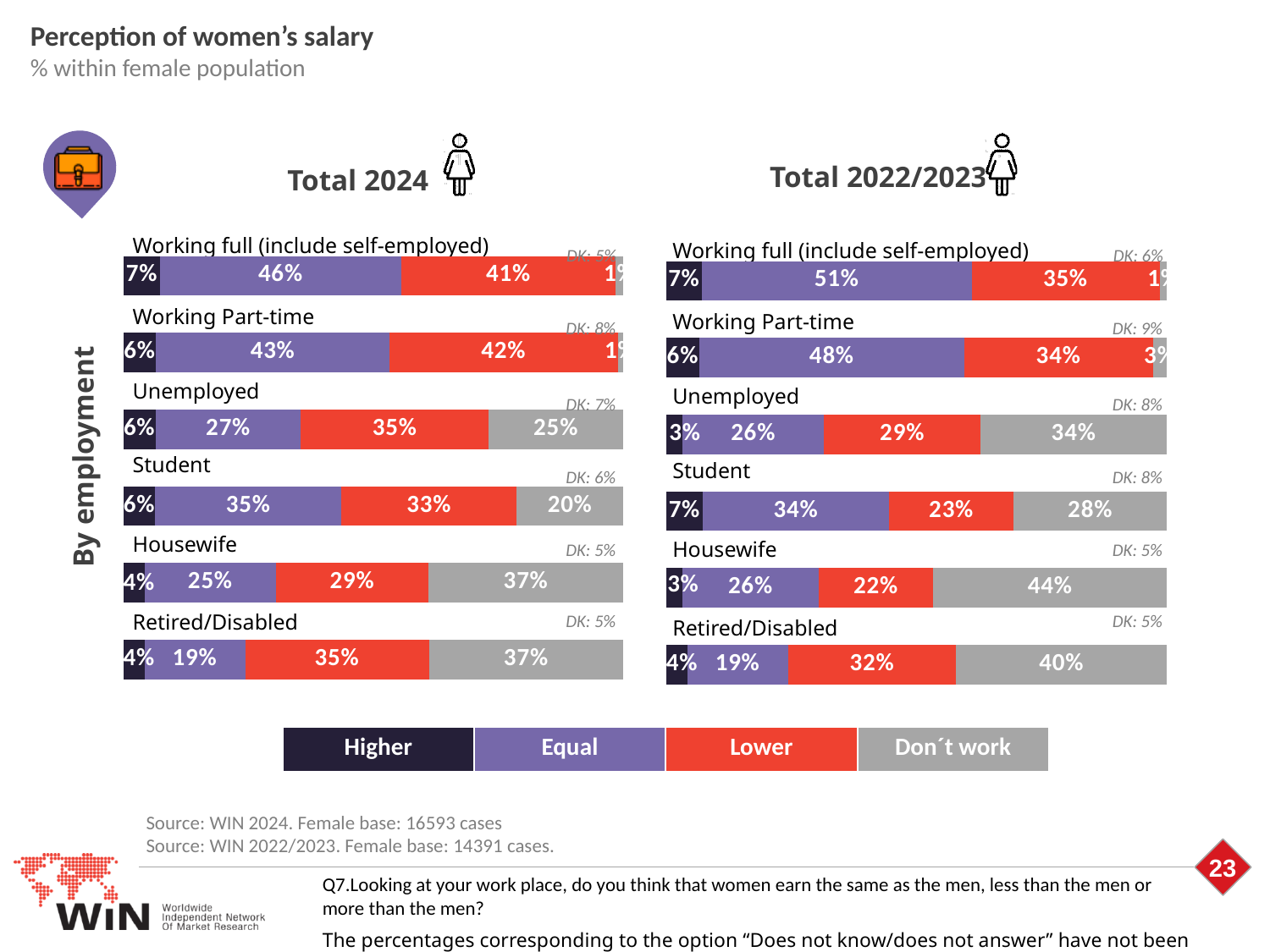
In the Total 2024 chart, which employment category has the lowest Equal share? Retired/Disabled How many series does the legend list? 4 How many employment categories are shown in the Total 2024 chart? 6 In the Total 2024 chart, what percentage of women working full (include self-employed) say their salary is Equal? 46% In the Total 2022/2023 chart, what percentage of Students say their salary is Lower? 23% What kind of chart is used for Total 2024? Stacked bar chart In the Total 2022/2023 chart, which employment category has the highest Don't work share? Housewife In the Total 2024 chart, what is the difference between the Lower and Equal shares for Housewife? 4 percentage points In the Total 2024 chart, what is the total of the four labelled segments for Unemployed? 93% Is the Equal share for women working full (include self-employed) larger in the Total 2024 chart or the Total 2022/2023 chart? Total 2022/2023 In the Total 2024 chart, for Unemployed women, which is larger: the Lower share or the Equal share? Lower In the Total 2024 chart, what is the DK value shown for Working Part-time? DK: 8%